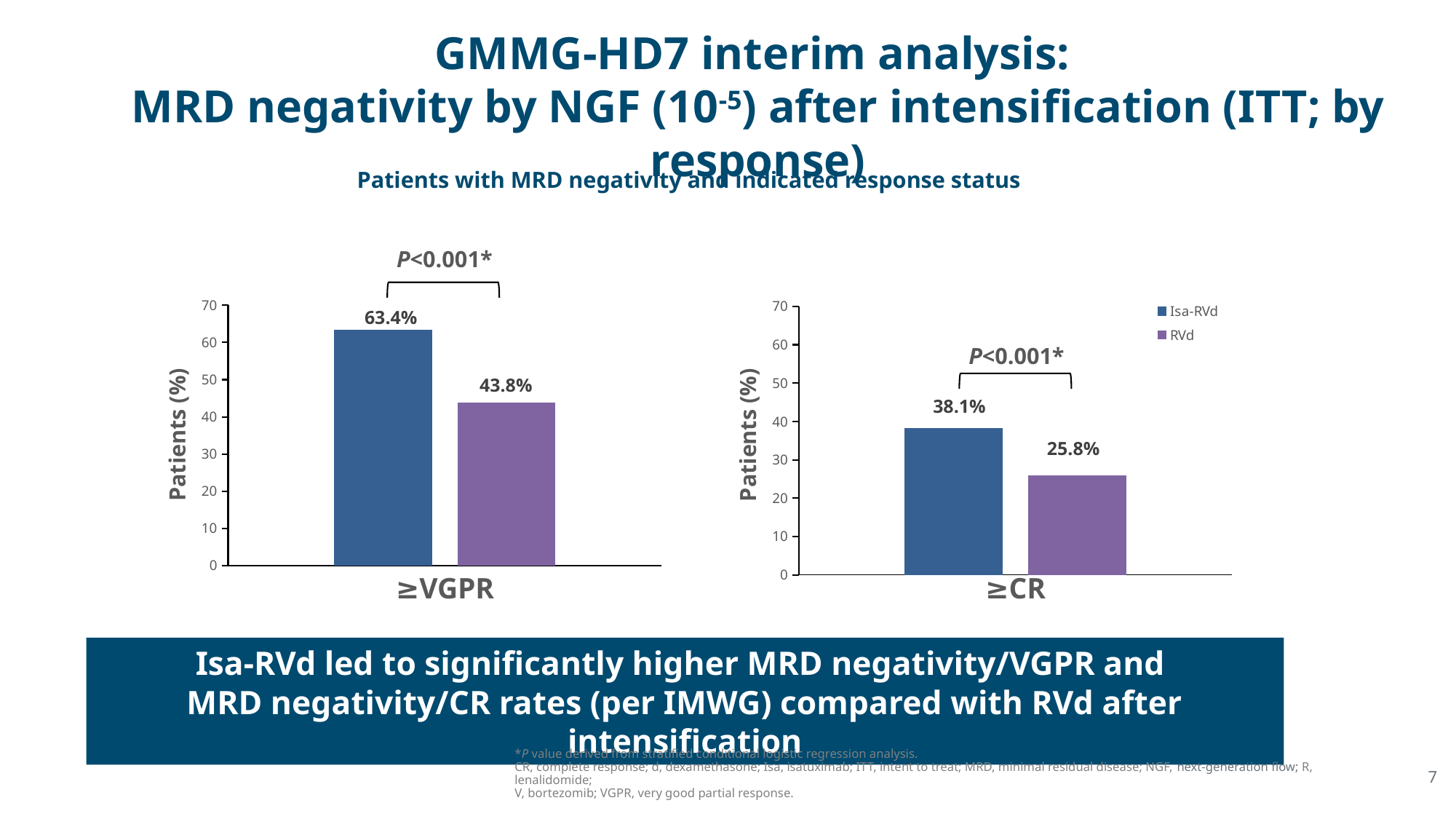
What kind of chart is the ≥CR chart on the right? Bar chart In the ≥VGPR chart on the left, is the value for Isa-RVd greater or less than 60? greater In the ≥VGPR chart on the left, which treatment arm has the lowest value? RVd In the ≥CR chart on the right, what is the value for Isa-RVd? 38.1% In the ≥CR chart on the right, what is the difference between the Isa-RVd and RVd values? 12.3% In the ≥VGPR chart on the left, what is the value for Isa-RVd? 63.4% In the ≥VGPR chart on the left, what is the difference between the Isa-RVd and RVd values? 19.6% In the ≥CR chart on the right, what is the value for RVd? 25.8% In the ≥CR chart on the right, which treatment arm has the higher value, Isa-RVd or RVd? Isa-RVd How many series does the legend on the slide list? 2 What is the label on the y axis of the ≥VGPR chart on the left? Patients (%) In the ≥VGPR chart on the left, what is the value for RVd? 43.8%